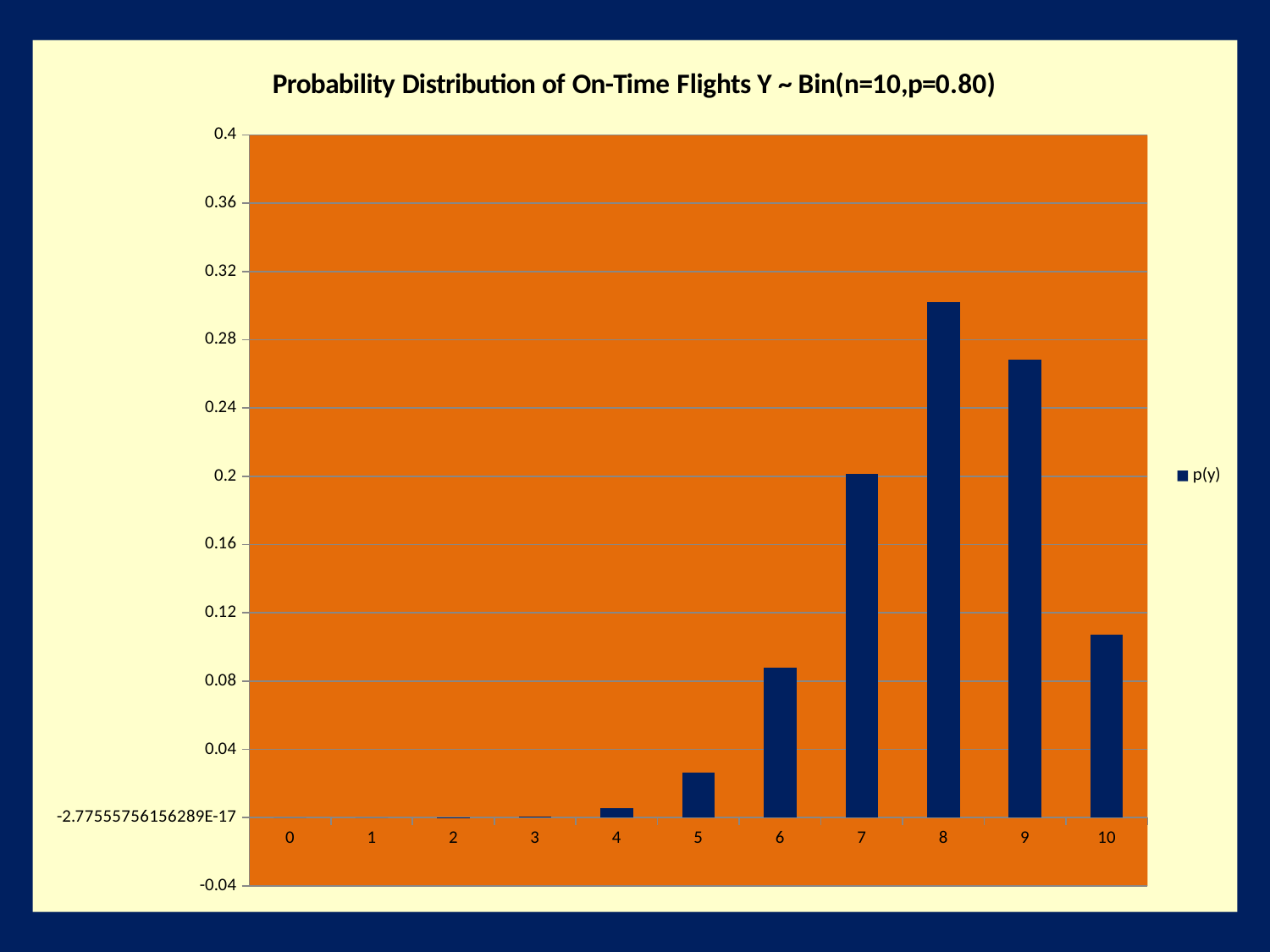
Which is larger, the value for category 8 or the value for category 9? 8 Is the value for category 8 greater or less than 0.28? greater Is the value for category 10 greater or less than 0.12? less Is the value for category 9 greater or less than 0.28? less Do the values rise or fall from category 8 to category 10? fall How many categories are shown on the x axis? 11 How many series does the legend list? 1 What is the title of the chart? Probability Distribution of On-Time Flights Y ~ Bin(n=10,p=0.80) Which category has the highest value? 8 What is the name of the series shown in the legend? p(y) What kind of chart is shown on the slide? bar chart